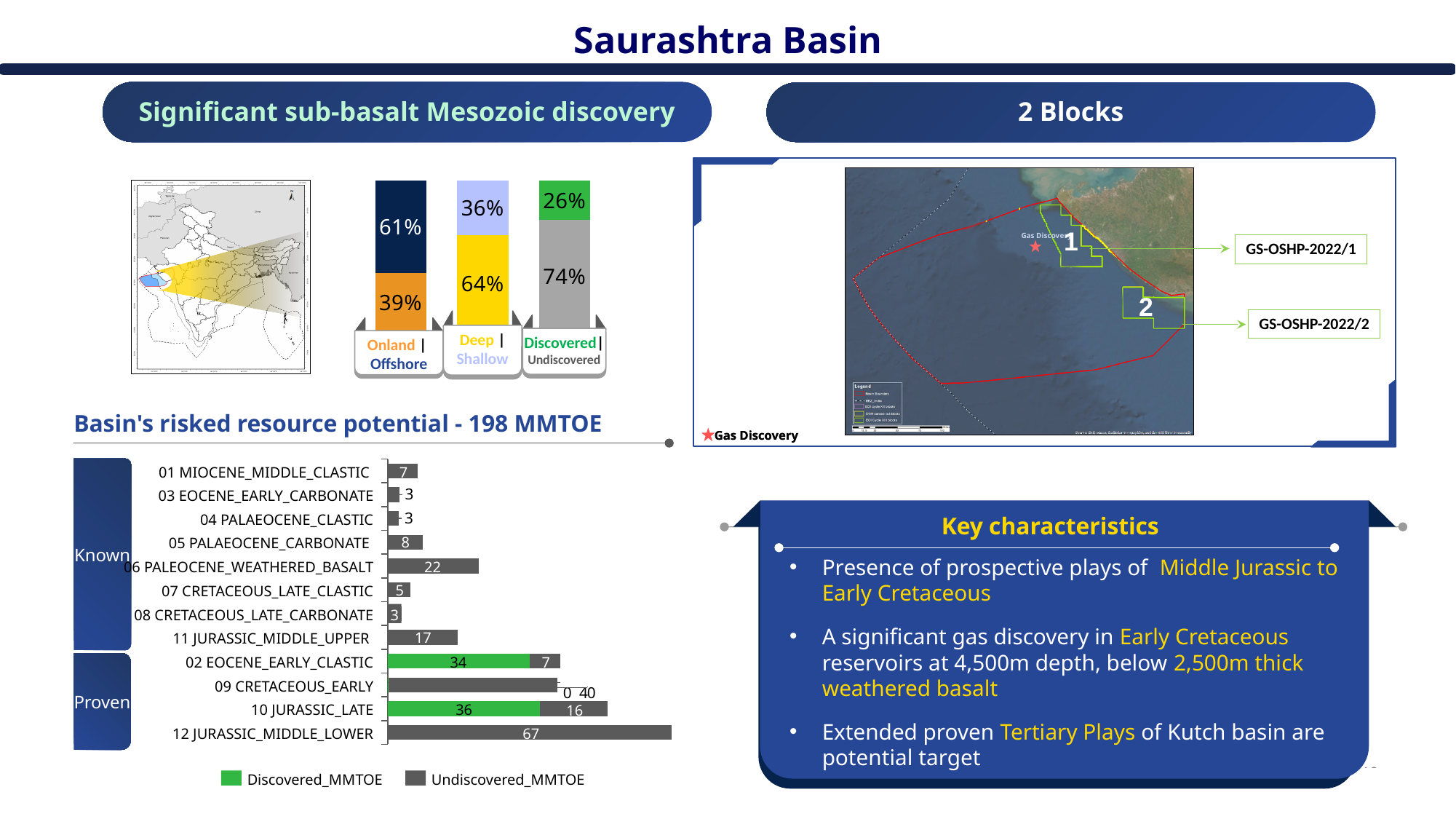
In the stacked percentage chart at the top left, what percentage is shown for Offshore? 61% How many categories are plotted in the 'Basin's risked resource potential - 198 MMTOE' chart? 12 In the 'Basin's risked resource potential - 198 MMTOE' chart, which is larger: the Discovered_MMTOE value for 02 EOCENE_EARLY_CLASTIC or for 10 JURASSIC_LATE? 10 JURASSIC_LATE In the 'Basin's risked resource potential - 198 MMTOE' chart, what is the Discovered_MMTOE value for 10 JURASSIC_LATE? 36 In the 'Basin's risked resource potential - 198 MMTOE' chart, what is the total of the stacked bar for 02 EOCENE_EARLY_CLASTIC? 41 In the 'Basin's risked resource potential - 198 MMTOE' chart, what is the Undiscovered_MMTOE value for 12 JURASSIC_MIDDLE_LOWER? 67 How many series does the legend of the 'Basin's risked resource potential - 198 MMTOE' chart list? 2 What type of chart is the 'Basin's risked resource potential - 198 MMTOE' chart? Stacked bar chart In the 'Basin's risked resource potential - 198 MMTOE' chart, what is the difference between the Undiscovered_MMTOE values for 06 PALEOCENE_WEATHERED_BASALT and 11 JURASSIC_MIDDLE_UPPER? 5 In the 'Basin's risked resource potential - 198 MMTOE' chart, which category has the largest Undiscovered_MMTOE value? 12 JURASSIC_MIDDLE_LOWER In the 'Basin's risked resource potential - 198 MMTOE' chart, what is the total of the stacked bar for 10 JURASSIC_LATE? 52 In the 'Basin's risked resource potential - 198 MMTOE' chart, what is the Undiscovered_MMTOE value for 06 PALEOCENE_WEATHERED_BASALT? 22